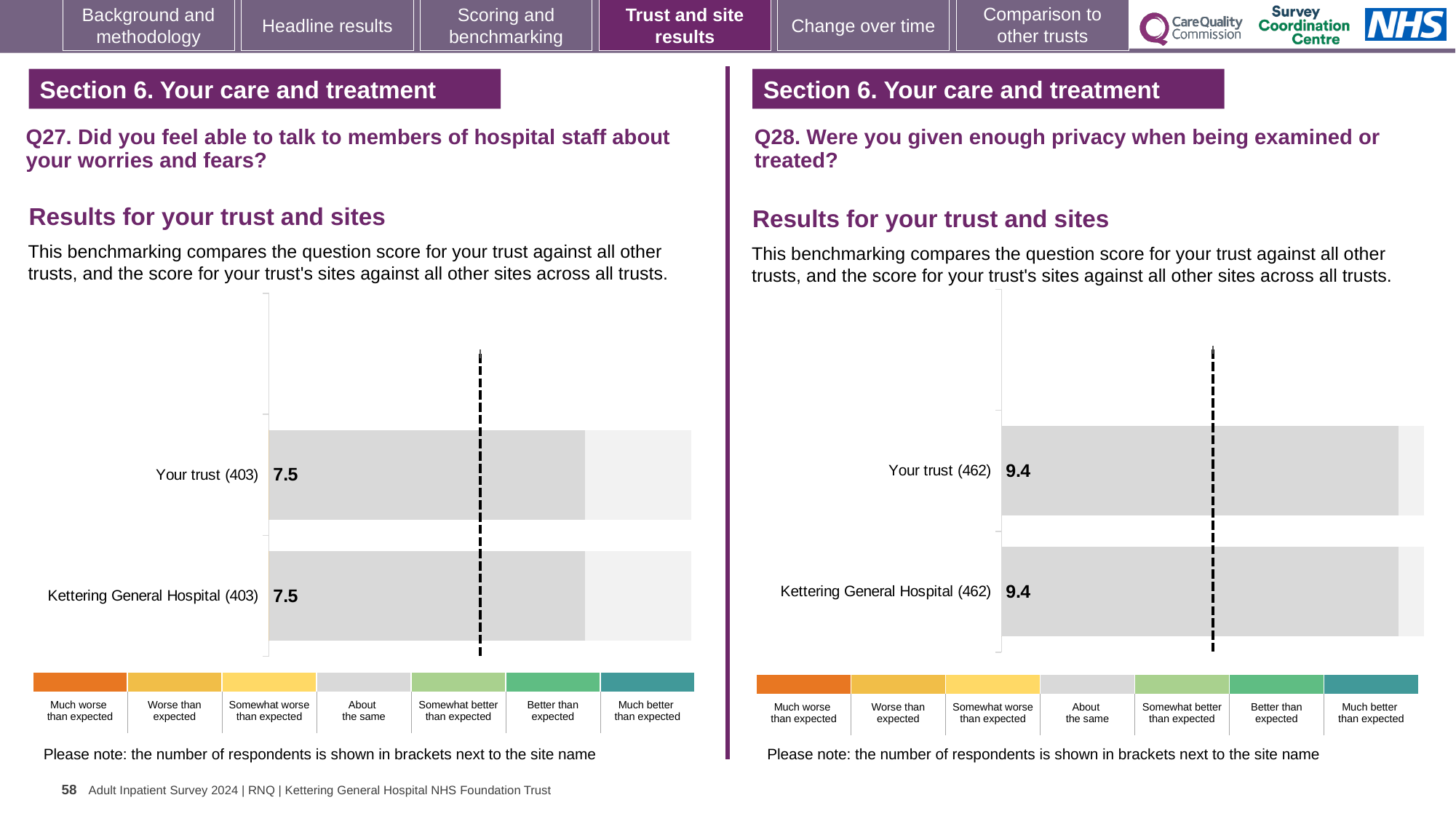
What kind of chart is the Q27 chart on the left? Bar chart On the Q28 chart (right), how many respondents are shown in brackets for Kettering General Hospital? 462 On the Q27 chart (left), what is the difference between the Your trust score and the Kettering General Hospital score? 0.0 On the Q28 chart (right), what is the score for Your trust? 9.4 On the Q28 chart (right), what is the score for Kettering General Hospital? 9.4 On the Q27 chart (left), what is the score for Kettering General Hospital? 7.5 On the Q27 chart (left), what is the score for Your trust? 7.5 On the Q28 chart (right), what is the difference between the Your trust score and the Kettering General Hospital score? 0.0 On the Q27 chart (left), how many bars are plotted? 2 How many categories does the colour key below each chart list? 7 On the Q27 chart (left), how many respondents are shown in brackets for Your trust? 403 On the Q28 chart (right), how many bars are plotted? 2